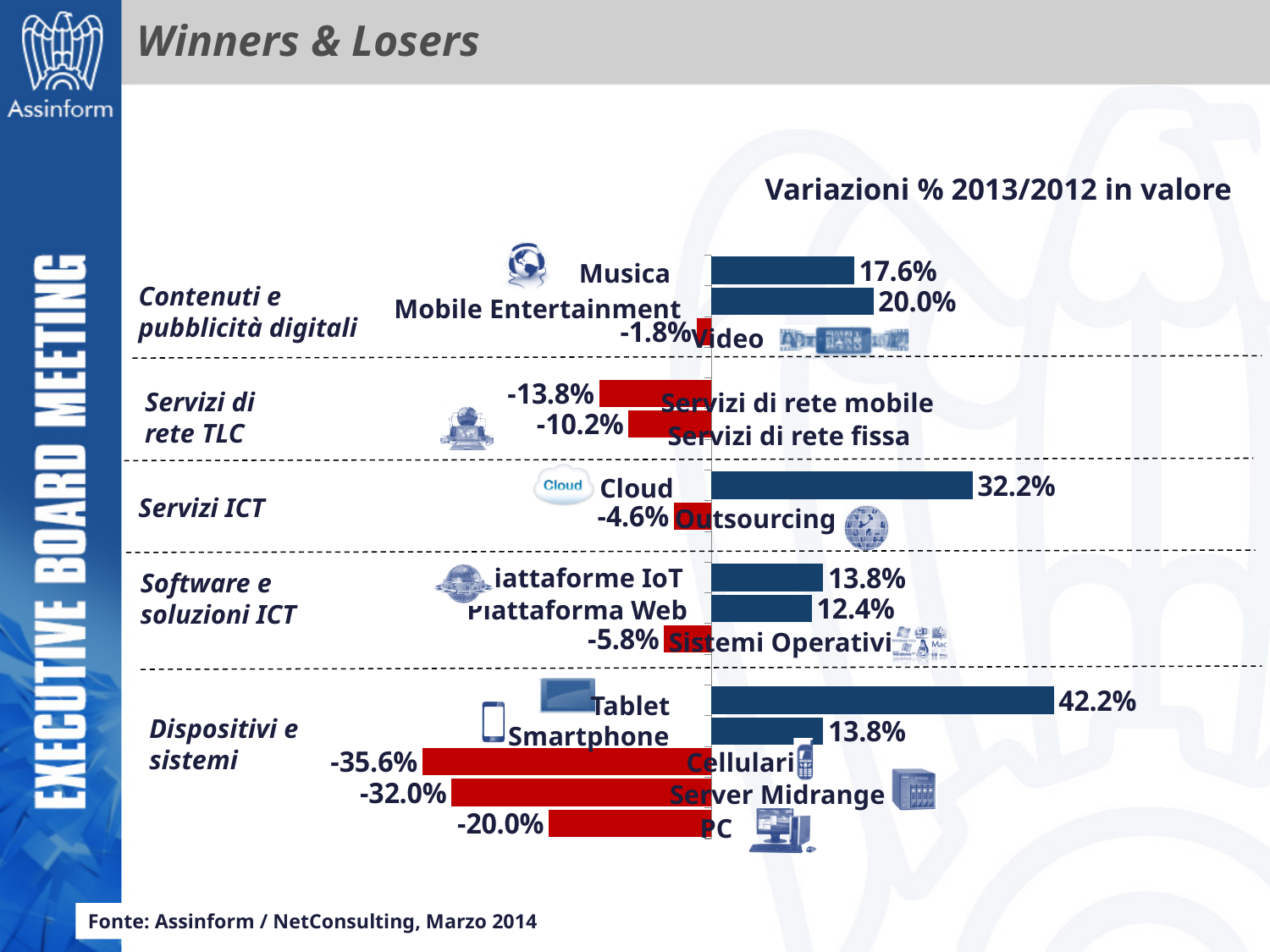
What is the title of the chart? Variazioni % 2013/2012 in valore How many categories are plotted in the chart? 15 What kind of chart is shown on the slide? Bar chart What is the difference between the percentage change for Mobile Entertainment and for Musica? 2.4% Which has a larger percentage change, Server Midrange or PC? PC What is the percentage change shown for Tablet? 42.2% What is the percentage change shown for Servizi di rete fissa? -10.2% Which category has the highest percentage change? Tablet What is the percentage change shown for Cloud? 32.2% What is the percentage change shown for Cellulari? -35.6% Which category has the lowest percentage change? Cellulari Which has a larger percentage change, Cloud or Piattaforme IoT? Cloud